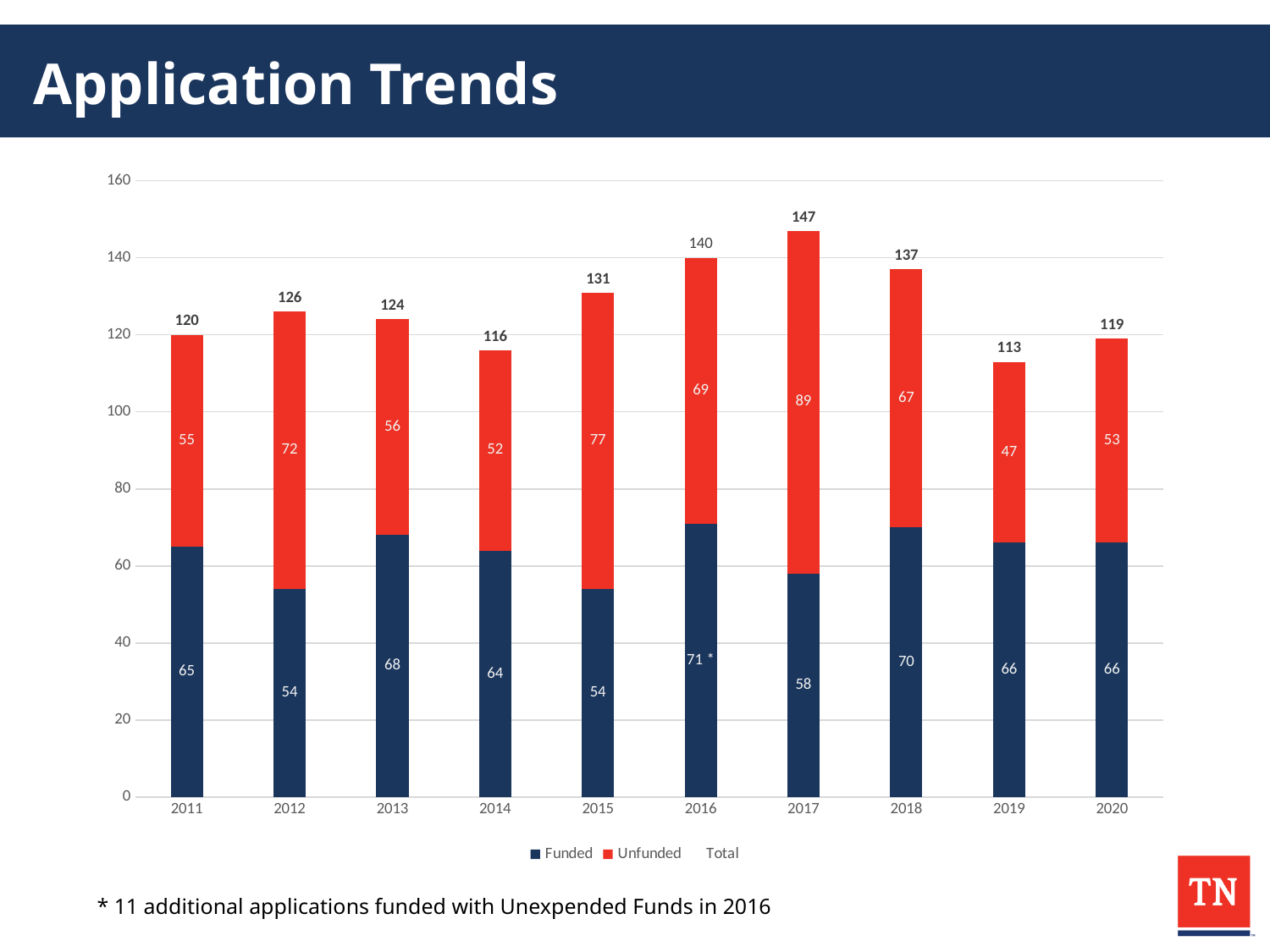
What is the difference between the Unfunded values for 2017 and 2019? 42 Which year has the lowest total number of applications? 2019 How many years are shown on the x axis of the chart? 10 What colour represents the Unfunded series in the chart? Red What is the total number of applications for 2018? 137 What type of chart is shown on the slide? Stacked bar chart Is the total for 2016 greater or less than 120? greater What is the Funded value for 2013? 68 Which year has the highest total number of applications? 2017 Which is larger, the Funded value for 2012 or the Funded value for 2018? 2018 How many entries does the chart's legend list? 3 What is the Unfunded value for 2017? 89